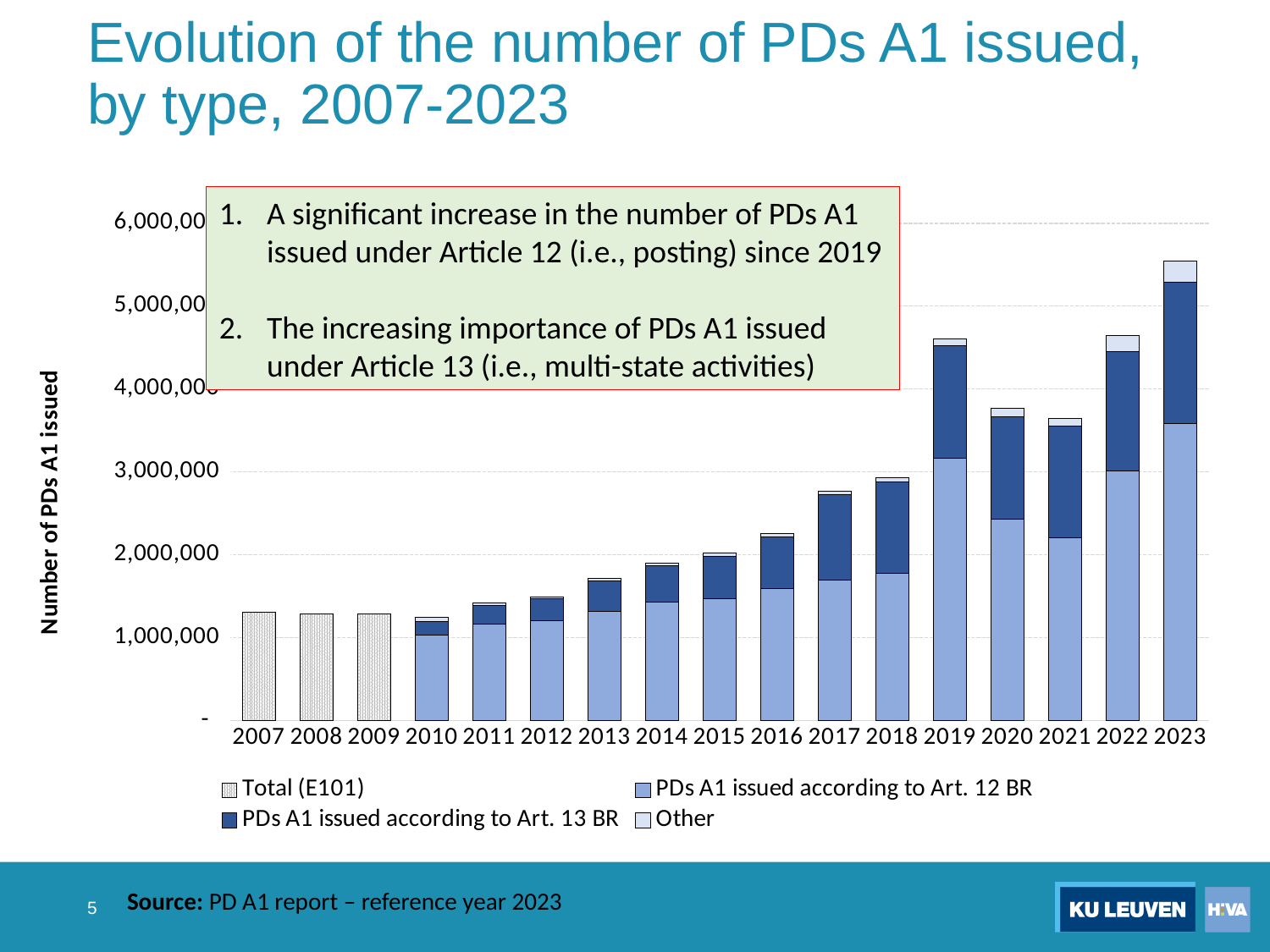
Which year has the highest total number of PDs A1 issued? 2023 Do the total bars generally rise or fall from 2010 to 2019? rise Which year has the larger total bar, 2019 or 2020? 2019 Is the total value for 2007 greater or less than 2,000,000? less What is the title of the chart's vertical axis? Number of PDs A1 issued How many series does the chart's legend list? 4 Is the total value for 2019 greater or less than 4,000,000? greater Is the total value for 2021 greater or less than 4,000,000? less What kind of chart is shown on the slide? Stacked bar chart How many years are shown along the x axis of the chart? 17